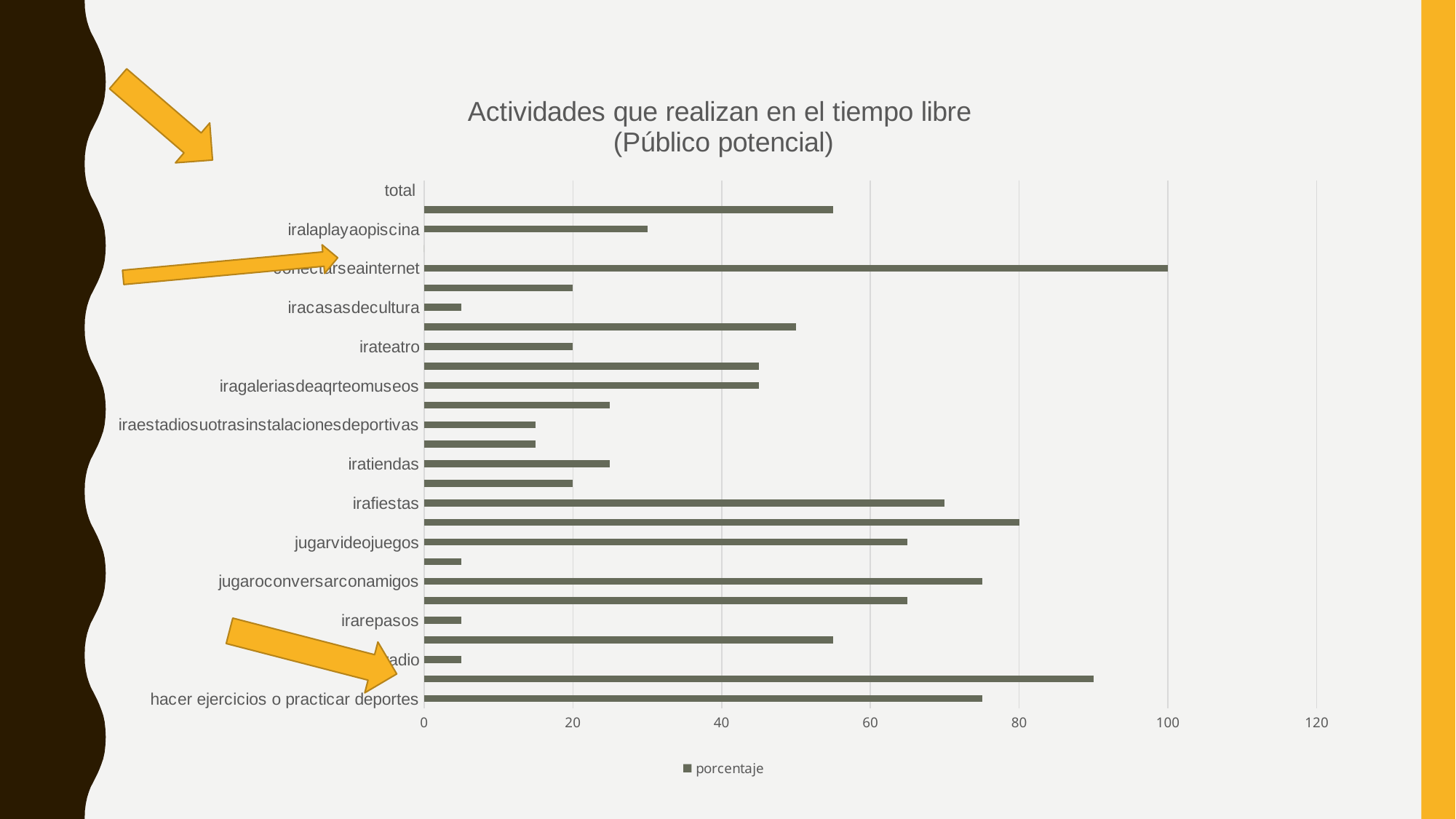
Which is larger, the value for irafiestas or the value for iratiendas? irafiestas What is the name of the series shown in the legend? porcentaje Is the value for jugaroconversarconamigos greater or less than 60? greater Which is larger, the value for iragaleriasdeaqrteomuseos or the value for irateatro? iragaleriasdeaqrteomuseos What is the value for irateatro? 20 Is the value for iracasasdecultura greater or less than 20? less What is the title of the chart? Actividades que realizan en el tiempo libre (Público potencial) Is the value for iralaplayaopiscina greater or less than 40? less How many series does the legend list? 1 What kind of chart is shown on the slide? bar chart